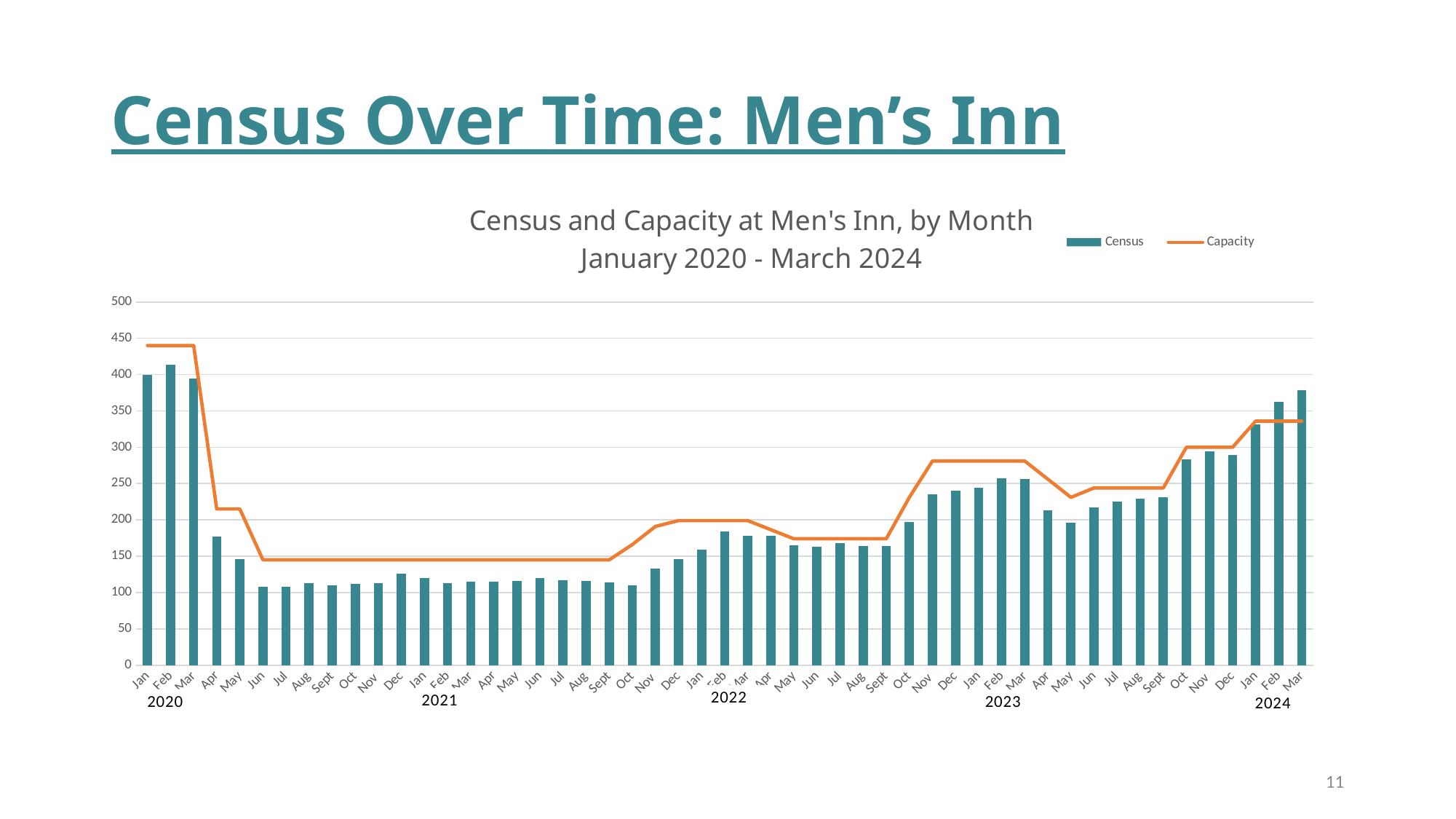
Does the Census value rise or fall from Jan 2020 to Jun 2020? fall Is the Capacity value for Nov 2022 greater or less than 250? greater Which is larger, the Census value for Feb 2020 or for Mar 2024? Feb 2020 How many series does the chart legend list? 2 Is the Census value for Jan 2020 greater or less than 350? greater Is the Census value for Oct 2023 greater or less than 300? less How many monthly bars are plotted for Census? 51 Which series is drawn as an orange line? Capacity In which month is the Census bar highest? Feb 2020 What is the title of the chart? Census and Capacity at Men's Inn, by Month January 2020 - March 2024